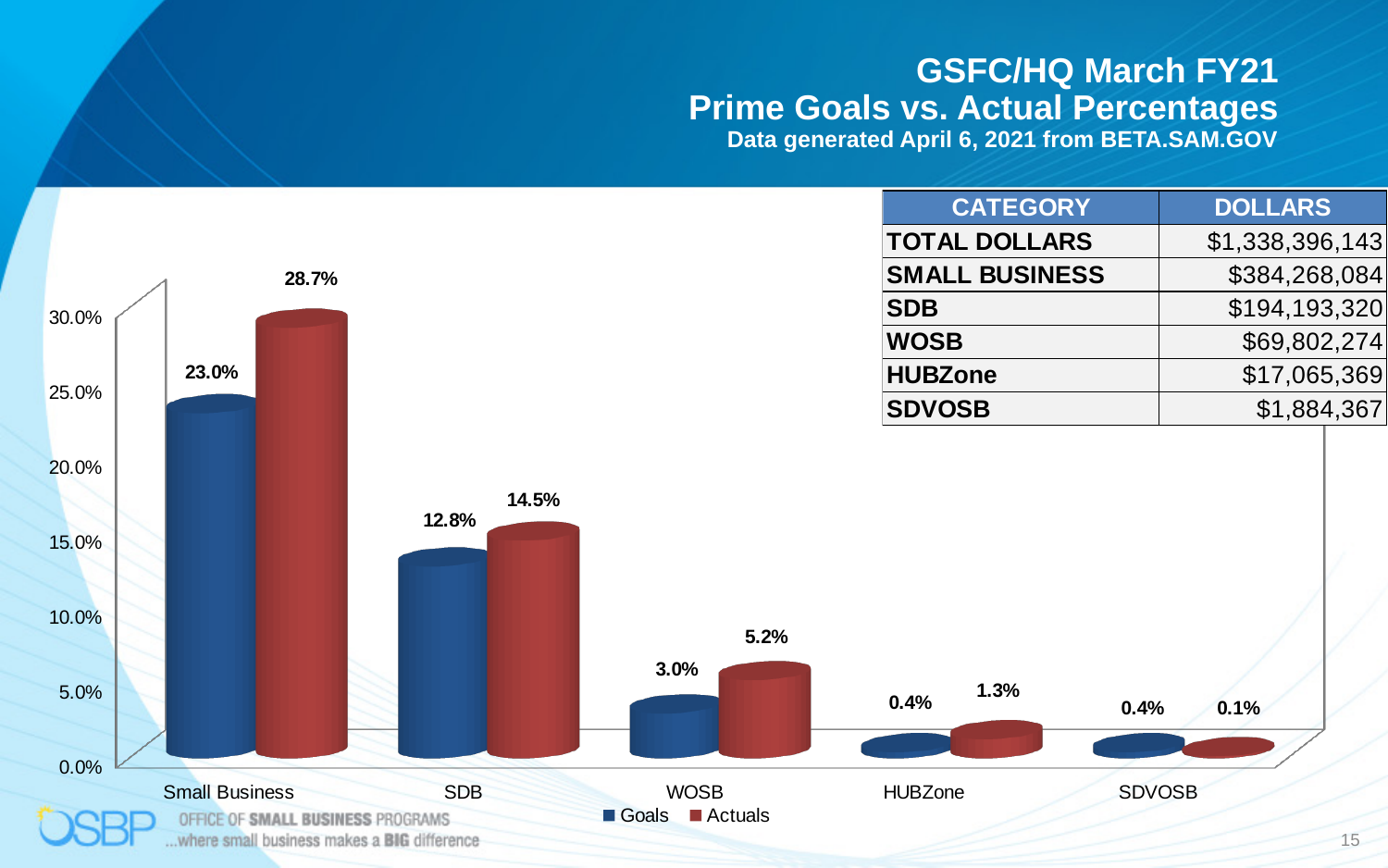
How many series does the chart legend list? 2 Is the Goals value for Small Business greater or less than 20.0%? greater Which is larger for SDVOSB, the Goals value or the Actuals value? Goals What is the Goals value for HUBZone? 0.4% What is the Actuals value for Small Business? 28.7% What kind of chart is shown on the slide? Bar chart What is the Goals value for SDB? 12.8% What is the Actuals value for WOSB? 5.2% What is the difference between the Actuals and Goals values for Small Business? 5.7% Which category has the highest Actuals value? Small Business How many categories are shown on the x axis of the chart? 5 Which category has the lowest Actuals value? SDVOSB